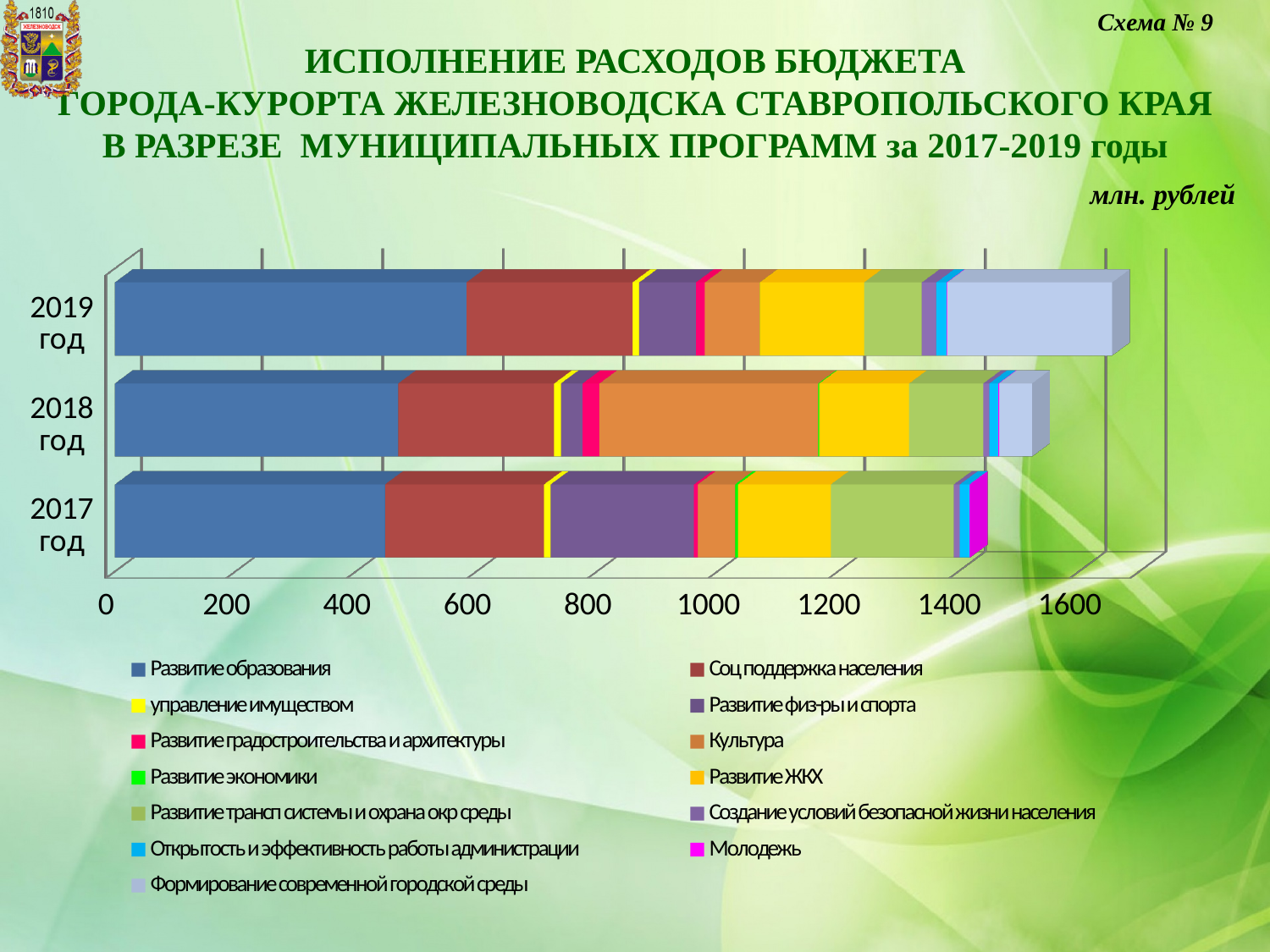
How many years (categories) are plotted on the chart? 3 Is the value of Развитие образования for 2019 год greater or less than 400? greater Is the total bar for 2019 год greater or less than 1600? greater Is the total bar for 2018 год greater or less than 1400? greater Do the total bars rise or fall from 2017 год to 2019 год? rise What kind of chart is shown on the slide? stacked bar chart How many series does the legend list? 13 In what units are the values on the chart expressed, according to the slide? млн. рублей Which total bar is longer, 2019 год or 2017 год? 2019 год Which year has the shortest total bar? 2017 год Which year has the longest total bar? 2019 год